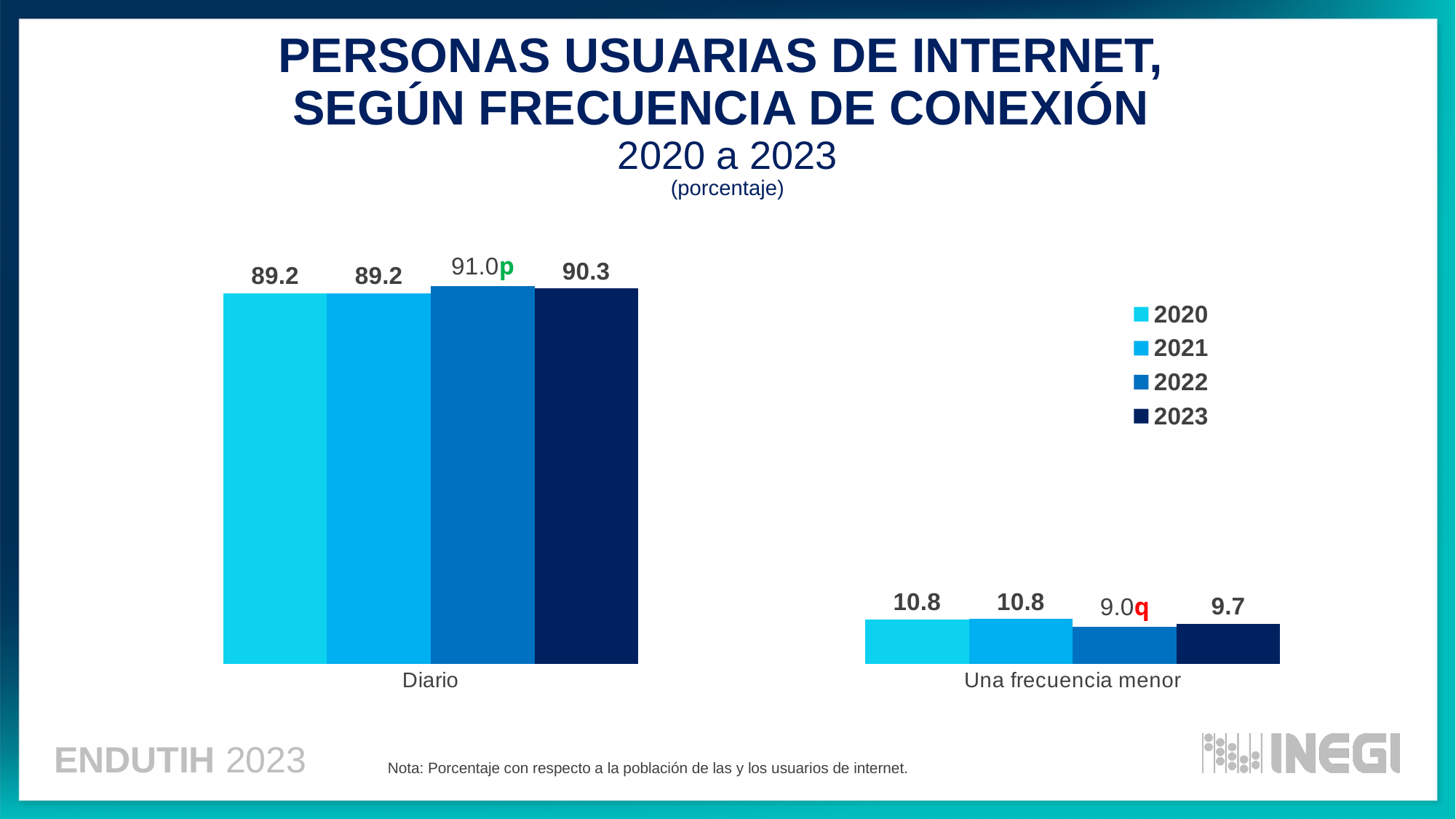
What kind of chart is shown on the slide? Bar chart What is the value for 2023 in the Diario category? 90.3 What is the value for 2020 in the Diario category? 89.2 What is the value for 2023 in the Una frecuencia menor category? 9.7 Which is larger: the 2023 value for Diario or the 2021 value for Diario? 2023 Which year has the highest value in the Diario category? 2022 What is the difference between the 2020 and 2023 values in the Una frecuencia menor category? 1.1 What is the difference between the 2022 and 2023 values in the Diario category? 0.7 Which year has the lowest value in the Una frecuencia menor category? 2022 What is the value for 2022 in the Una frecuencia menor category? 9.0 How many series does the legend list? 4 How many categories are shown on the x axis? 2